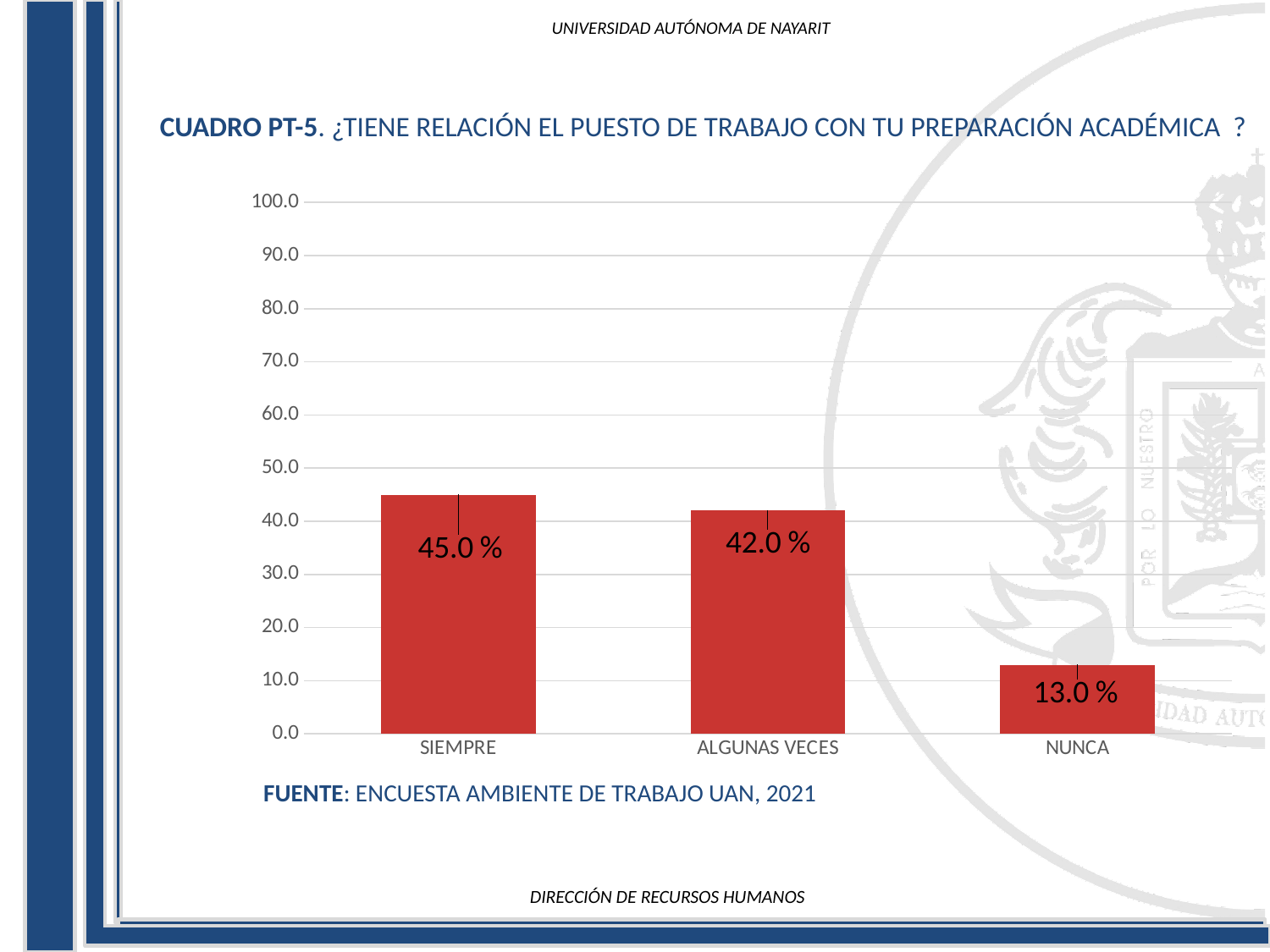
Which is larger, the value for ALGUNAS VECES or the value for NUNCA? ALGUNAS VECES How many categories are shown on the x axis? 3 What kind of chart is shown on the slide? bar chart Which category has the lowest value? NUNCA What is the value for ALGUNAS VECES? 42.0 % What is the difference between the values for SIEMPRE and ALGUNAS VECES? 3.0 % What source is cited below the chart? ENCUESTA AMBIENTE DE TRABAJO UAN, 2021 What is the value for NUNCA? 13.0 % Which category has the highest value? SIEMPRE Is the value for NUNCA greater or less than 20.0? less What is the value for SIEMPRE? 45.0 % What is the difference between the values for SIEMPRE and NUNCA? 32.0 %